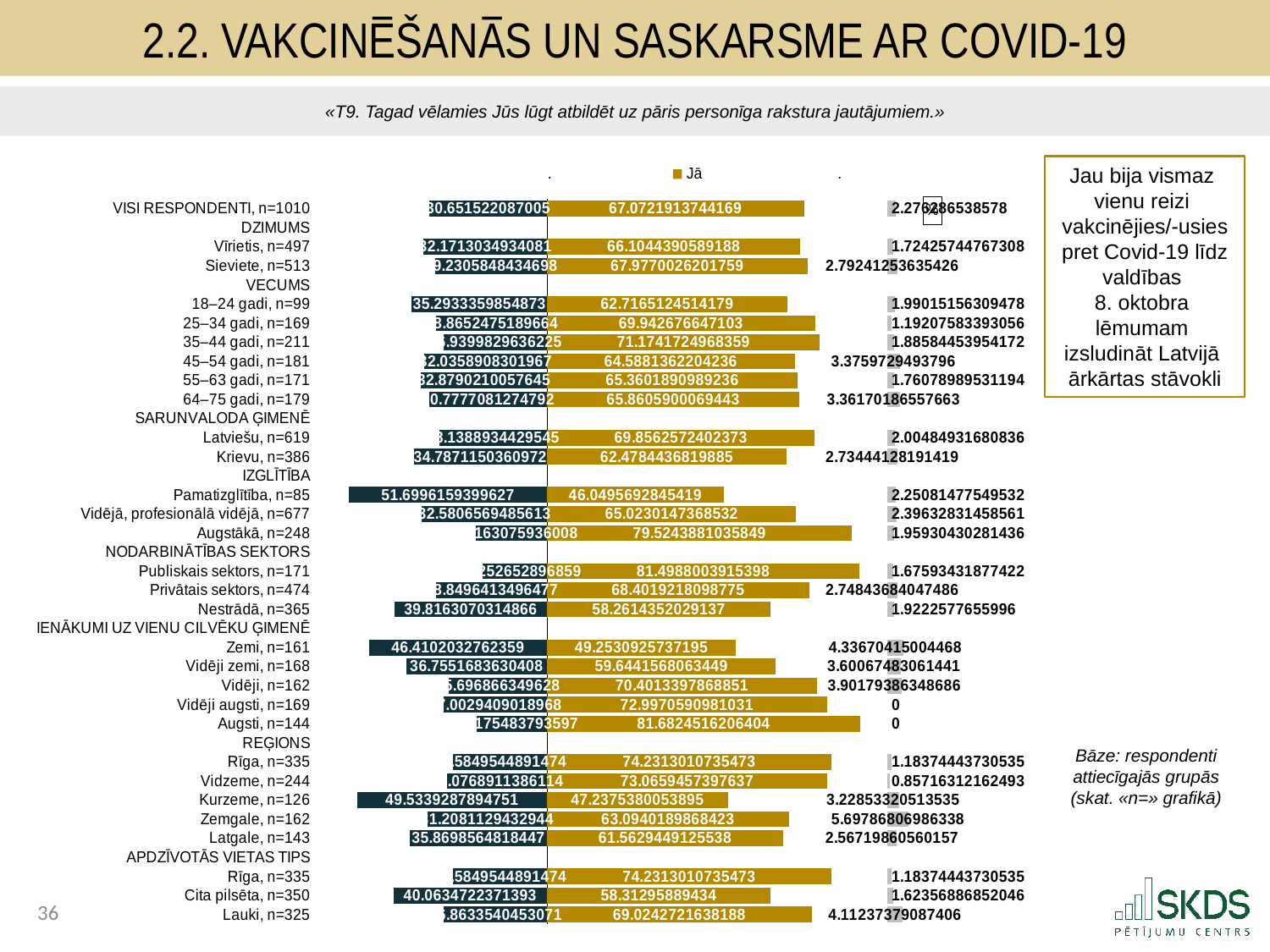
What is the value of the grey (right) segment for Zemgale, n=162? 5.69786806986338 What is the "Jā" value for VISI RESPONDENTI, n=1010? 67.0721913744169 Which has the larger "Jā" value: Rīga, n=335 or Latgale, n=143? Rīga, n=335 What is the value of the grey (right) segment for Augsti, n=144? 0 What is the "Jā" value for Kurzeme, n=126? 47.2375380053895 How many category bars are plotted in the chart? 30 Which has the larger "Jā" value: Latviešu, n=619 or Krievu, n=386? Latviešu, n=619 What kind of chart is shown on the slide? bar chart What is the difference between the "Jā" values for Sieviete, n=513 and Vīrietis, n=497? 1.8725635612571 What colour is the "Jā" series in the chart? gold What is the "Jā" value for Publiskais sektors, n=171? 81.4988003915398 What is the value of the dark (left) segment for Pamatizglītība, n=85? 51.6996159399627